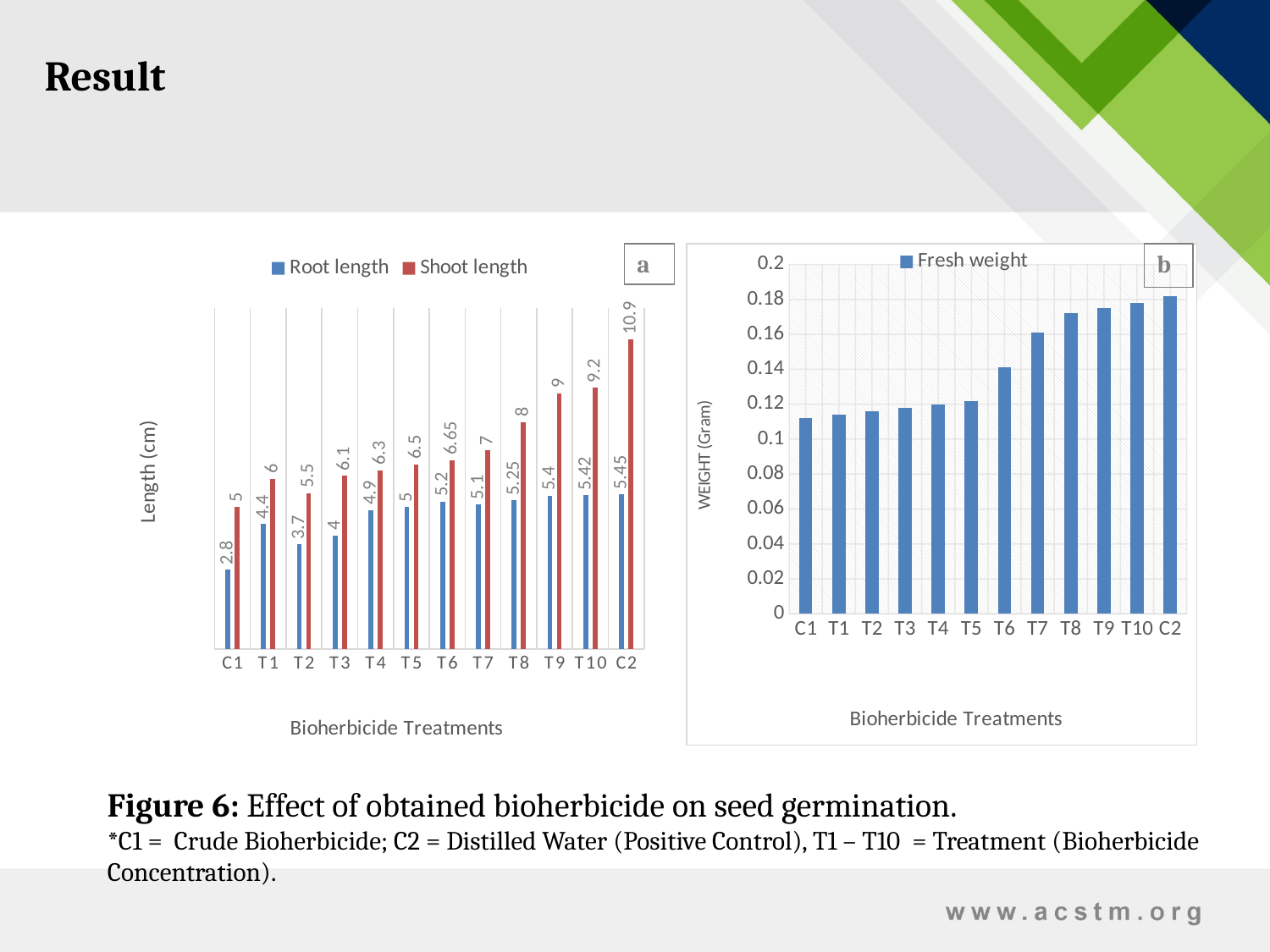
In the left chart (a), what is the Root length for C1? 2.8 In the left chart (a), what is the Root length for T6? 5.2 What kind of chart is the right chart (b)? bar chart In the left chart (a), which is larger, the Root length for T1 or the Root length for T2? T1 In the left chart (a), which treatment has the highest Shoot length? C2 In the right chart (b), is the Fresh weight for C2 greater or less than 0.16? greater In the right chart (b), is the Fresh weight for C1 greater or less than 0.12? less In the left chart (a), what is the Shoot length for C2? 10.9 In the left chart (a), which treatment has the lowest Root length? C1 How many treatments are shown on the x axis of the right chart (b)? 12 In the left chart (a), what is the difference between the Shoot length and Root length for T8? 2.75 How many series does the legend of the left chart (a) list? 2